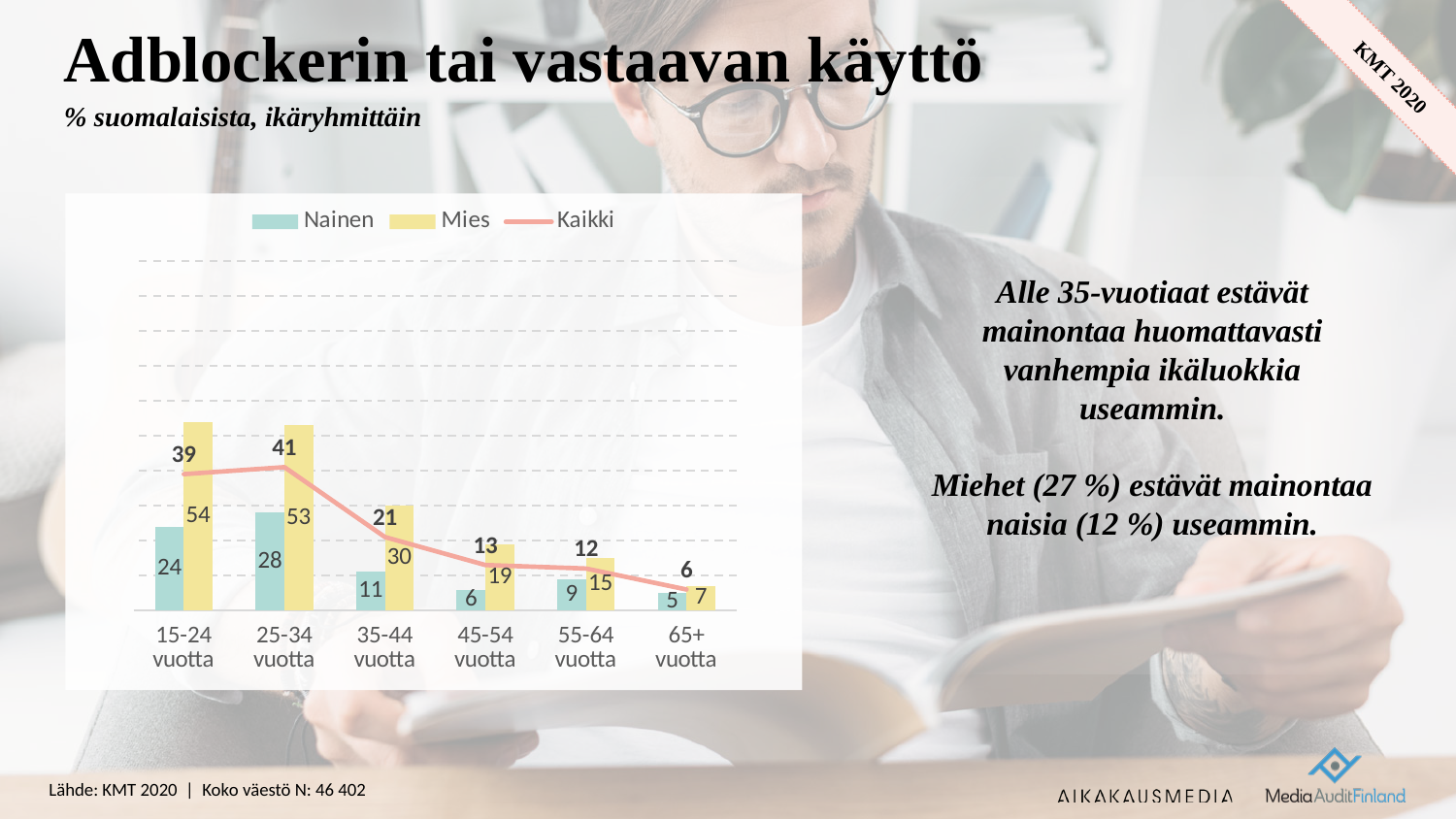
Do the Kaikki values generally rise or fall from the 25-34 vuotta group to the 65+ vuotta group? Fall Which age group has the highest Kaikki value? 25-34 vuotta What kind of chart is shown on the slide? Bar chart with a line Which is larger for the 45-54 vuotta age group, the Nainen value or the Mies value? Mies What is the Nainen value for the 25-34 vuotta age group? 28 What is the Mies value for the 15-24 vuotta age group? 54 What is the Kaikki value for the 35-44 vuotta age group? 21 How many series does the legend list? 3 What is the Nainen value for the 65+ vuotta age group? 5 Which age group has the lowest Mies value? 65+ vuotta What is the difference between the Mies and Nainen values for the 15-24 vuotta age group? 30 How many age groups are shown on the x axis? 6